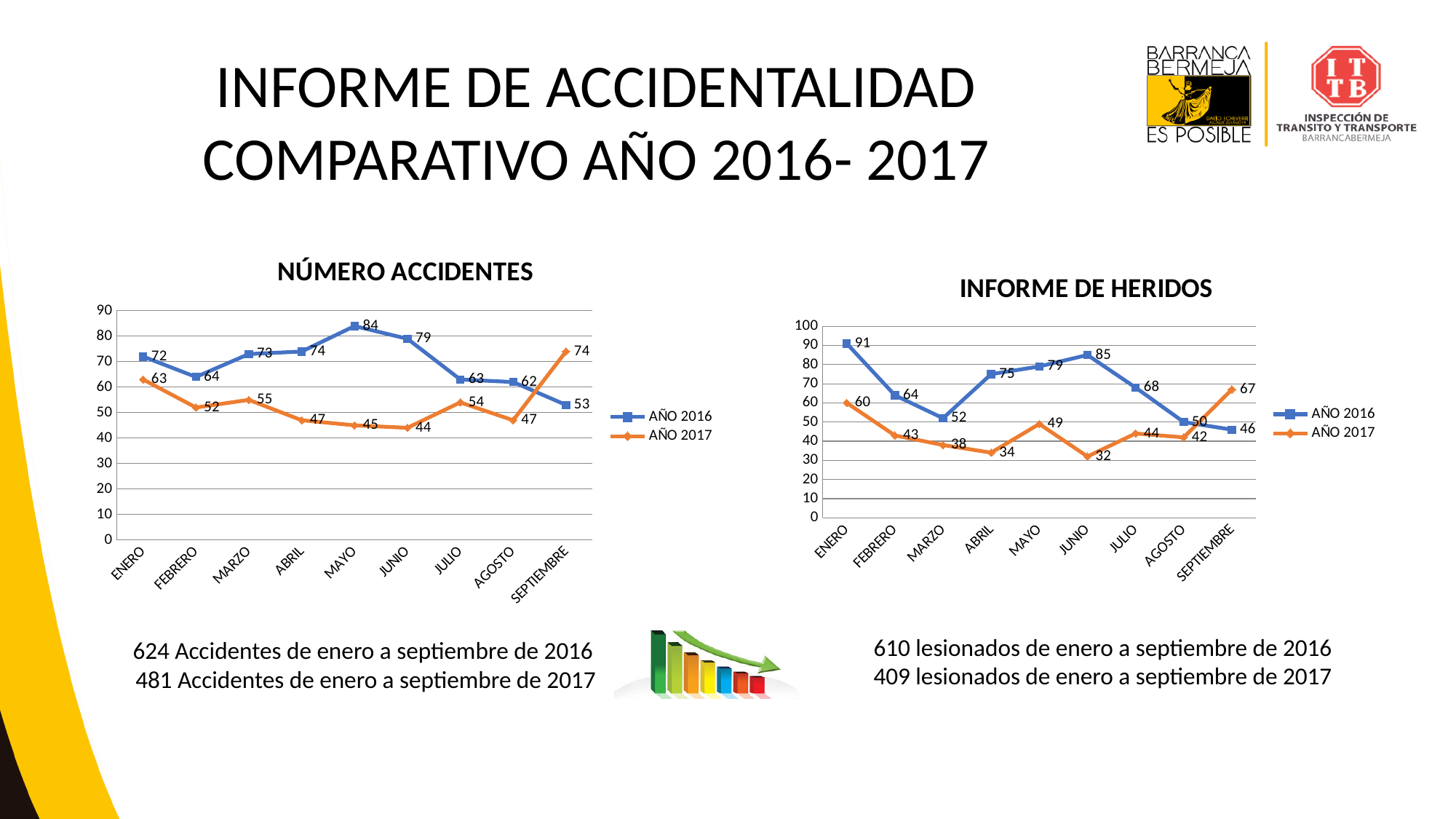
What type of chart is the NÚMERO ACCIDENTES chart? Line chart In the NÚMERO ACCIDENTES chart, which series has the larger value in SEPTIEMBRE, AÑO 2016 or AÑO 2017? AÑO 2017 In the NÚMERO ACCIDENTES chart, what is the value for AÑO 2016 in MAYO? 84 In the NÚMERO ACCIDENTES chart, what is the difference between AÑO 2016 and AÑO 2017 in ENERO? 9 In the NÚMERO ACCIDENTES chart, which month has the lowest value for AÑO 2017? JUNIO In the INFORME DE HERIDOS chart, which month has the lowest value for AÑO 2016? SEPTIEMBRE In the INFORME DE HERIDOS chart, what is the difference between AÑO 2016 and AÑO 2017 in JUNIO? 53 In the INFORME DE HERIDOS chart, what is the value for AÑO 2016 in ENERO? 91 In the NÚMERO ACCIDENTES chart, which month has the highest value for AÑO 2016? MAYO In the NÚMERO ACCIDENTES chart, what is the value for AÑO 2017 in SEPTIEMBRE? 74 How many months are shown on the x axis of the INFORME DE HERIDOS chart? 9 In the INFORME DE HERIDOS chart, what is the value for AÑO 2017 in JUNIO? 32